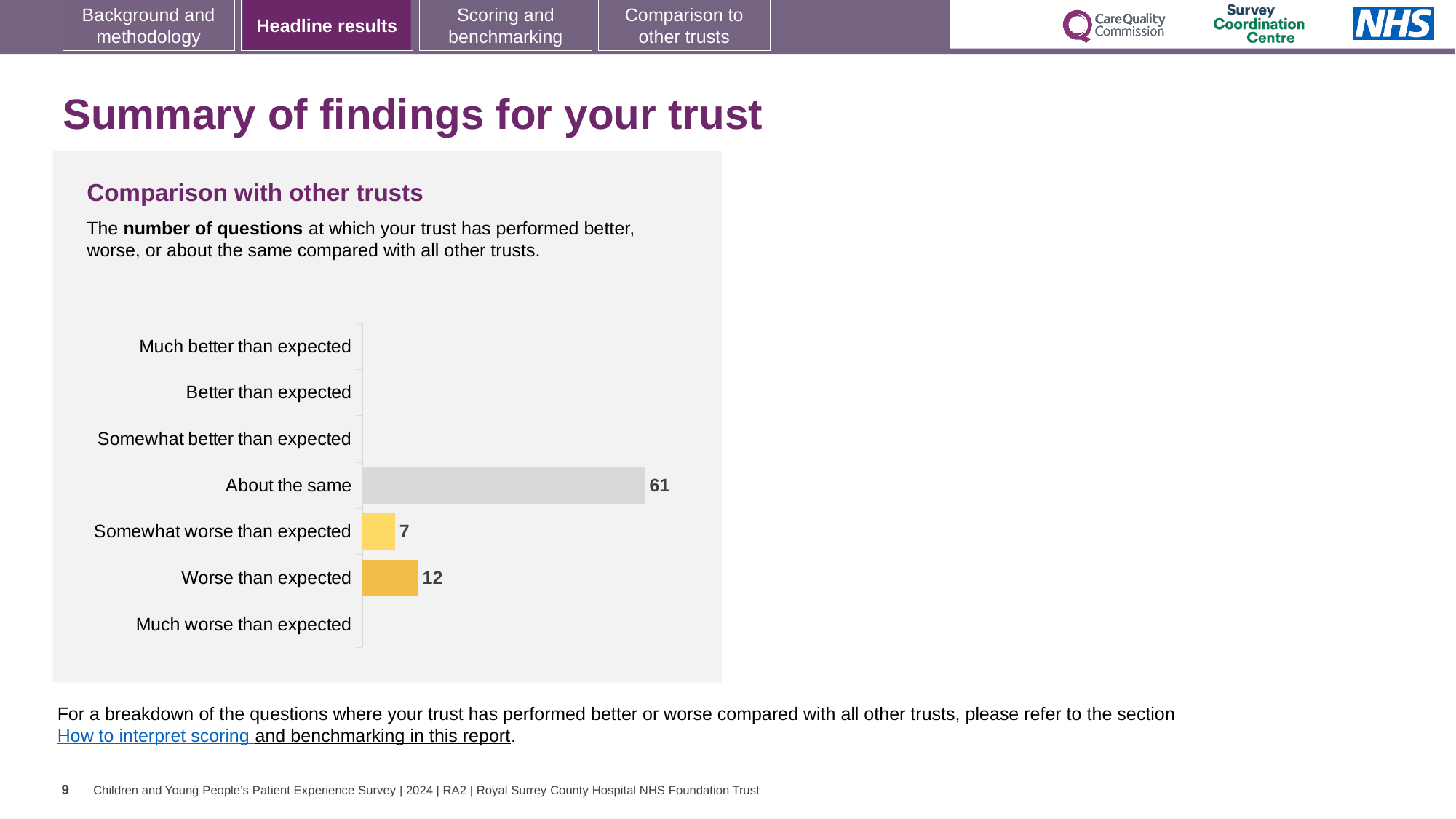
How many categories are listed on the chart's axis? 7 Which category has the highest number of questions? About the same Which is larger: 'Worse than expected' or 'Somewhat worse than expected'? Worse than expected What kind of chart is shown on the slide? Bar chart What is the title of the chart section? Comparison with other trusts What is the difference between the 'Worse than expected' and 'Somewhat worse than expected' values? 5 What is the difference between the 'About the same' and 'Worse than expected' values? 49 How many questions are in the 'About the same' category? 61 What is the value for 'Somewhat worse than expected'? 7 What is the value for 'Worse than expected'? 12 What is the total of the three labelled bars on the chart? 80 What colour is the 'About the same' bar? Grey